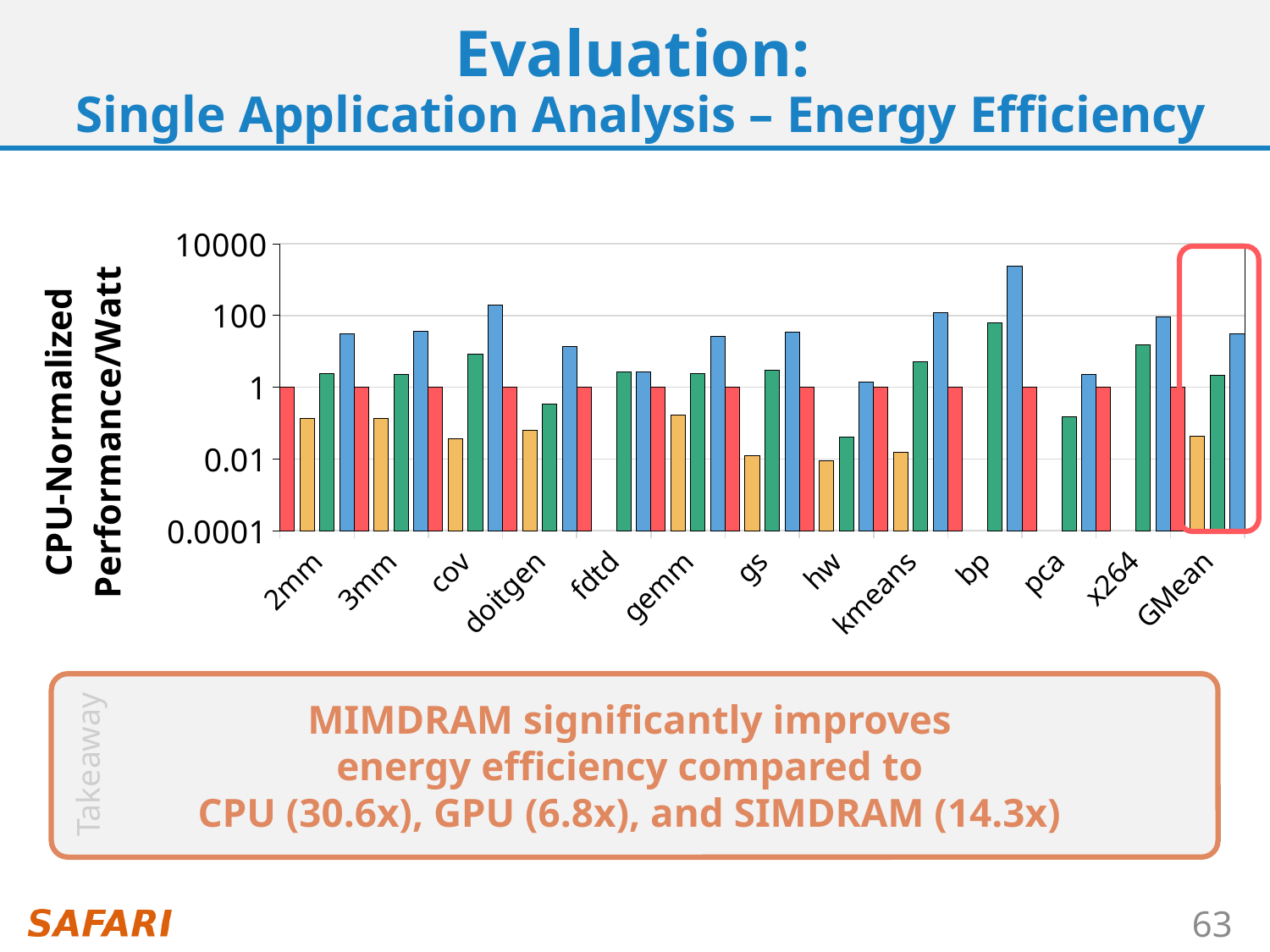
Is the value of the green bar for hw greater or less than 1? less Is the value of the orange bar for GMean greater or less than 1? less Is the value of the blue bar for 2mm greater or less than 1? greater Which category has the highest blue bar in the chart? bp What kind of chart is shown on the slide? bar chart What is the y-axis label of the chart? CPU-Normalized Performance/Watt What is the value of the red bar for GMean? 1 What is the value of the red bar for 2mm? 1 How many application categories are shown on the x axis of the chart? 13 Which is larger, the blue bar for bp or the blue bar for pca? bp